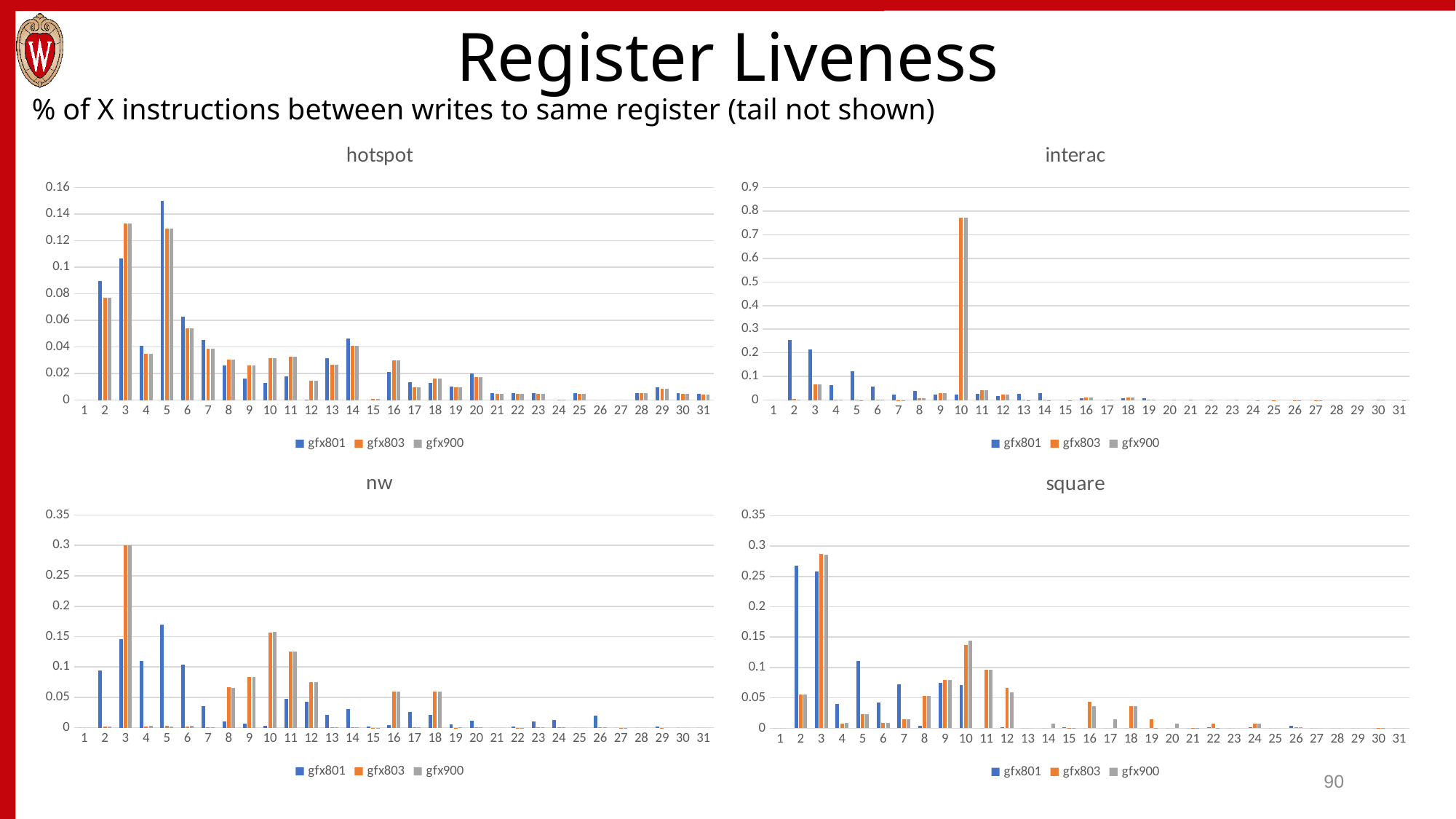
What kind of chart is the hotspot chart? bar chart In the nw chart, is the gfx803 value for category 3 greater or less than 0.25? greater In the square chart, is the gfx801 value for category 2 greater or less than 0.25? greater How many series does the legend of the interac chart list? 3 In the hotspot chart, which is larger for category 2: gfx801 or gfx803? gfx801 In the nw chart, which is larger for category 3: gfx801 or gfx803? gfx803 What is the title of the bottom-right chart? square In the interac chart, is the gfx801 value for category 2 greater or less than 0.2? greater How many categories are shown on the x axis of the nw chart? 31 In the interac chart, which category has the highest gfx803 value? 10 In the hotspot chart, which category has the highest gfx801 value? 5